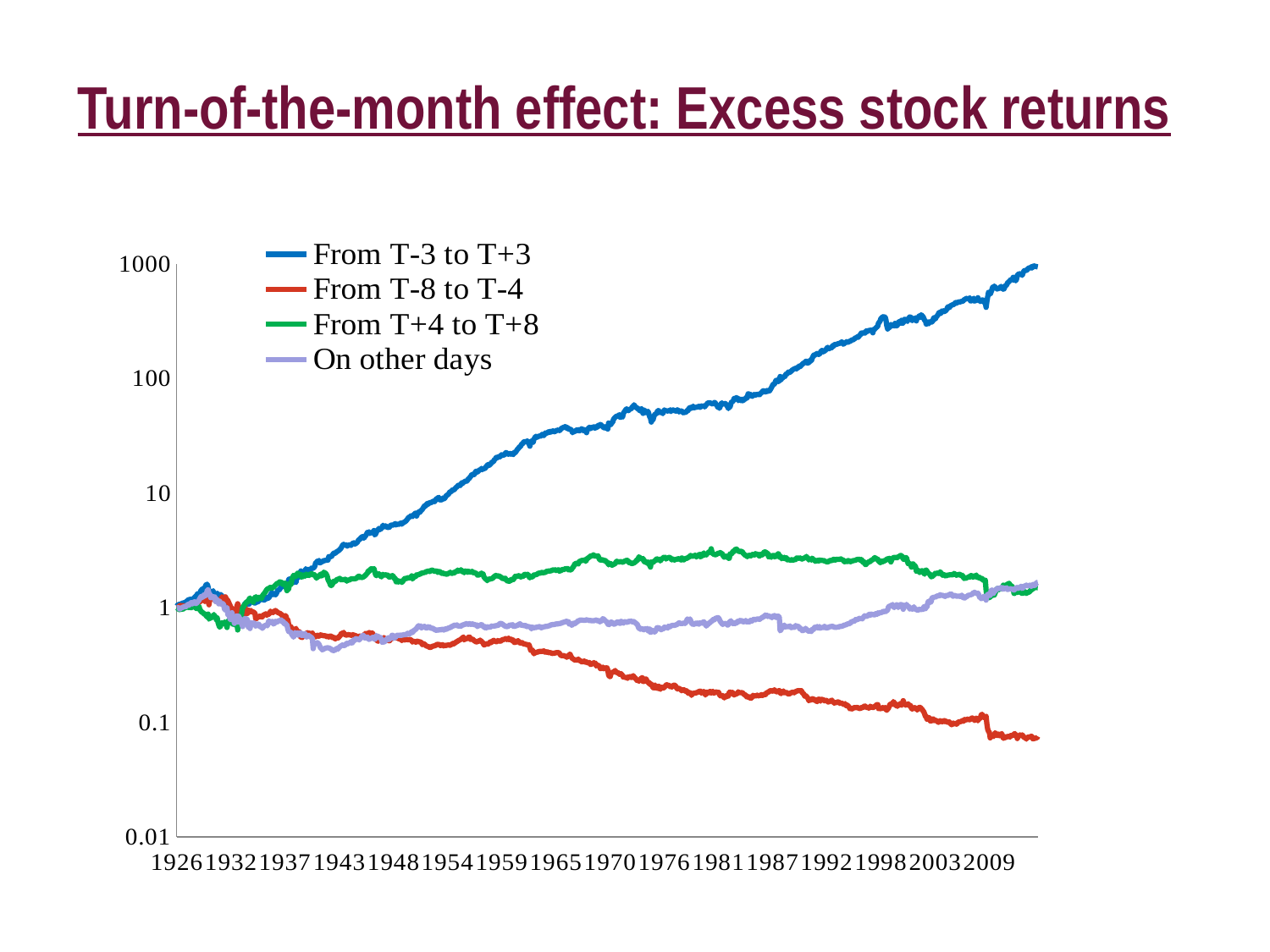
Does the 'From T-8 to T-4' series rise or fall from 1926 to 2009? fall What is the highest tick value shown on the y axis? 1000 Which series has the lowest value at the right end of the chart (2009)? From T-8 to T-4 At the right end of the chart, which is larger: 'From T+4 to T+8' or 'From T-8 to T-4'? From T+4 to T+8 Which series has the highest value at the right end of the chart (2009)? From T-3 to T+3 Does the 'From T-3 to T+3' series rise or fall from 1926 to 2009? rise How many series does the legend list? 4 What kind of chart is shown on the slide? line chart What is the title of the slide? Turn-of-the-month effect: Excess stock returns Is the value for 'From T-8 to T-4' at the end of the chart greater or less than 0.1? less Is the highest value reached by the 'From T+4 to T+8' series greater or less than 10? less Is the value for 'From T-3 to T+3' at the end of the chart greater or less than 100? greater